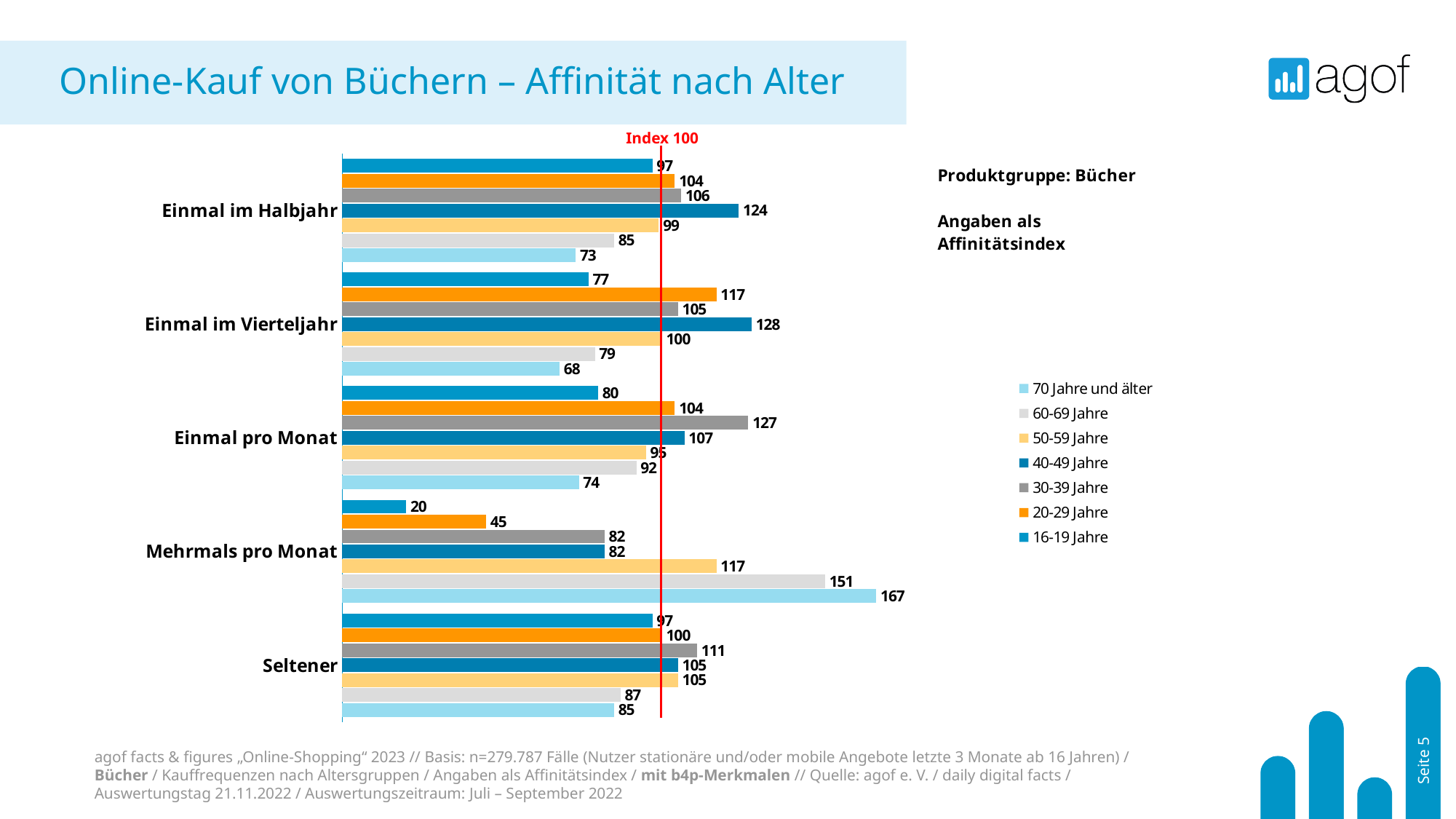
What is the value for 70 Jahre und älter in the category "Mehrmals pro Monat"? 167 What is the value for 30-39 Jahre in the category "Einmal pro Monat"? 127 In the category "Seltener", which is larger: the value for 30-39 Jahre or the value for 60-69 Jahre? 30-39 Jahre What value does the red vertical reference line on the chart mark? Index 100 What is the value for 16-19 Jahre in the category "Mehrmals pro Monat"? 20 What is the affinity index for 40-49 Jahre in the category "Einmal im Halbjahr"? 124 How many purchase-frequency categories are shown on the chart? 5 What is the difference between the values for 60-69 Jahre and 20-29 Jahre in the category "Mehrmals pro Monat"? 106 How many age groups does the legend list? 7 Which age group has the lowest value in the category "Mehrmals pro Monat"? 16-19 Jahre Which age group has the highest value in the category "Einmal im Vierteljahr"? 40-49 Jahre What type of chart is shown on the slide? Bar chart